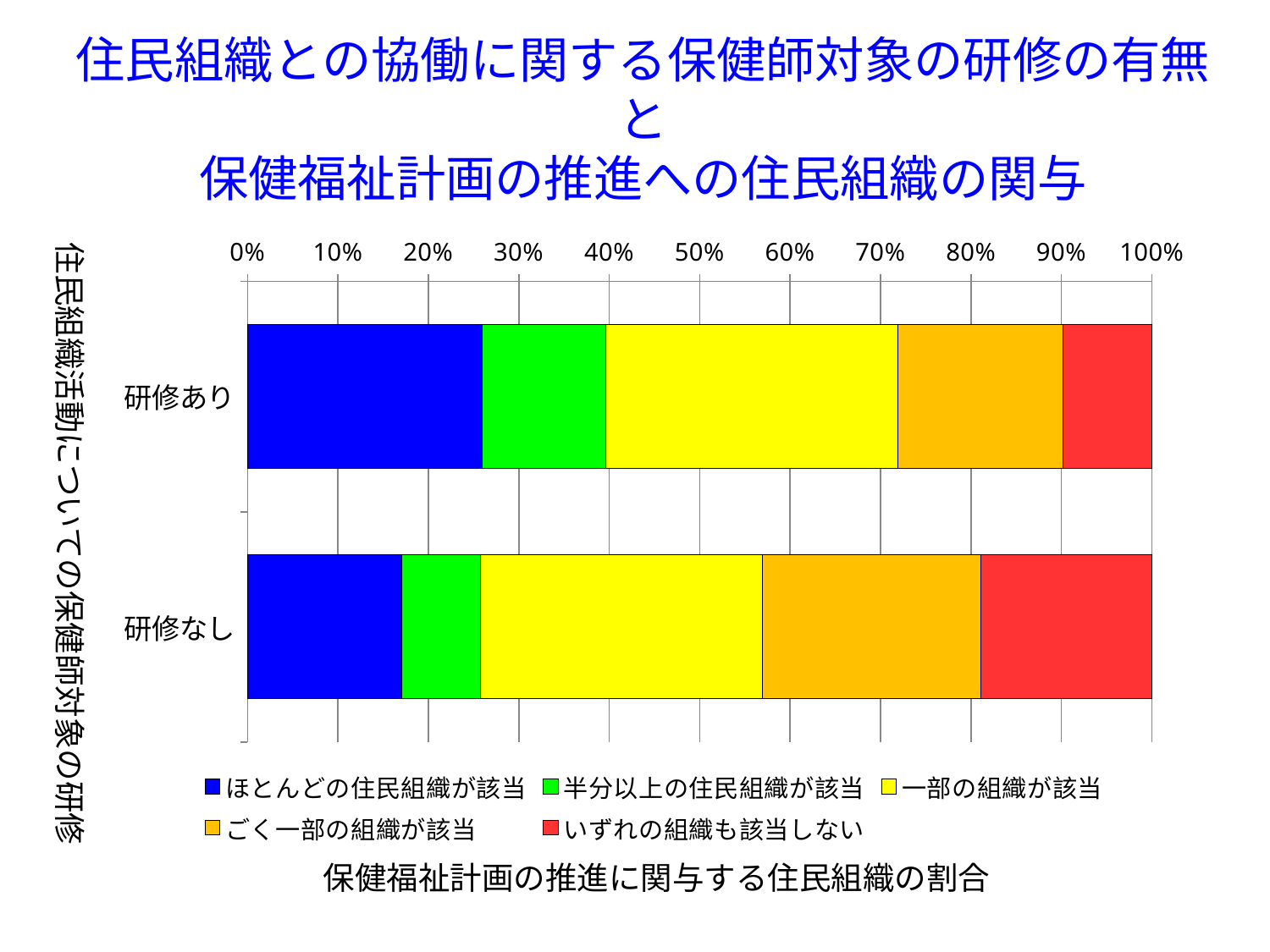
Which category has the larger share for ほとんどの住民組織が該当, 研修あり or 研修なし? 研修あり How many categories are plotted on the vertical axis? 2 How many series does the legend list? 5 Is the share of ほとんどの住民組織が該当 for 研修あり greater or less than 20%? greater What kind of chart is shown on the slide? stacked bar chart Which series is shown in red in the legend? いずれの組織も該当しない What is the label of the horizontal axis at the bottom of the chart? 保健福祉計画の推進に関与する住民組織の割合 Is the share of ごく一部の組織が該当 for 研修なし greater or less than 20%? greater Which series takes up the largest segment of the 研修あり bar? 一部の組織が該当 Which category has the larger share for いずれの組織も該当しない, 研修あり or 研修なし? 研修なし Is the share of いずれの組織も該当しない for 研修あり greater or less than 20%? less